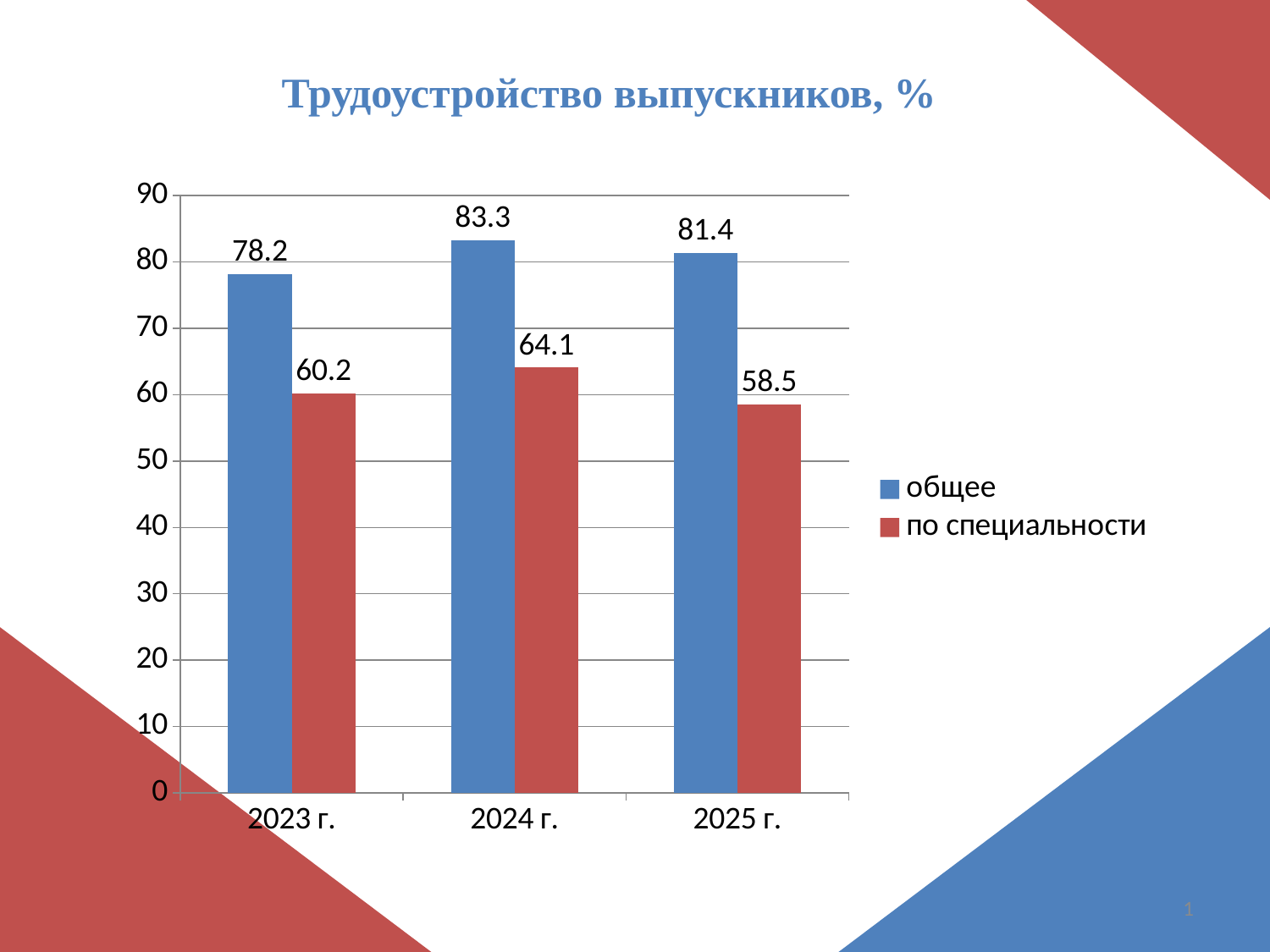
How many years are shown on the x axis? 3 What kind of chart is shown on the slide? Bar chart What is the value for "по специальности" in 2024 г.? 64.1 In which year is the "по специальности" value lowest? 2025 г. What is the difference between the "общее" and "по специальности" values in 2023 г.? 18 In which year is the "общее" value highest? 2024 г. What is the title of the chart? Трудоустройство выпускников, % How many series does the legend list? 2 What is the value for "общее" in 2023 г.? 78.2 What is the difference between the "общее" values for 2024 г. and 2025 г.? 1.9 What is the value for "по специальности" in 2025 г.? 58.5 Which is larger: the "по специальности" value in 2024 г. or in 2023 г.? 2024 г.